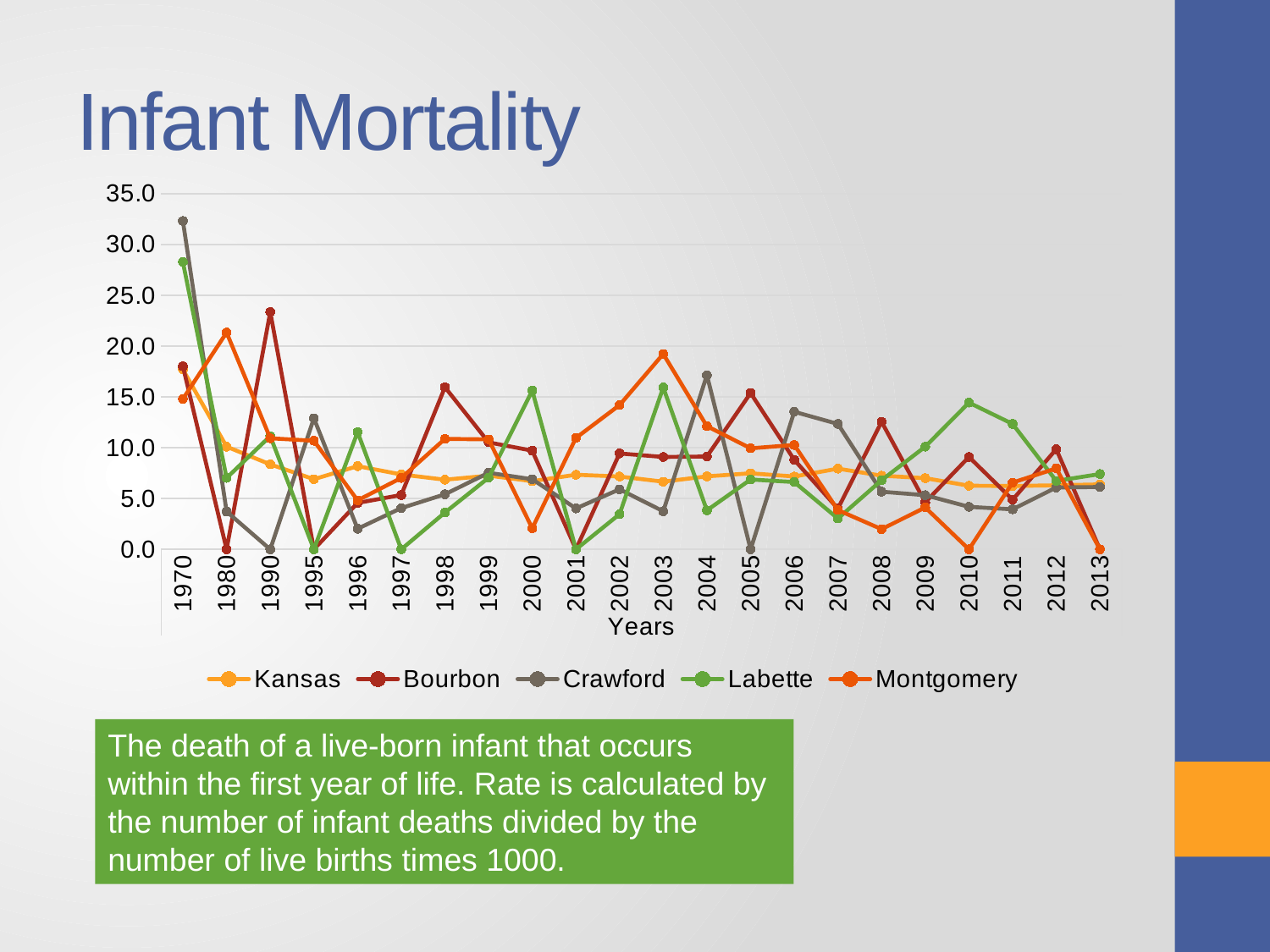
What is the value for Montgomery in 2013? 0.0 In which year does the Crawford series reach its highest value? 1970 Does the Kansas series generally rise or fall from 1970 to 2013? Fall What kind of chart is shown on the slide? Line chart How many series does the legend list? 5 Which is larger in 2010, the value for Labette or the value for Montgomery? Labette How many years are shown along the x axis? 22 Is the value for Kansas in 2013 greater or less than 10.0? less Is the value for Crawford in 1970 greater or less than 30.0? greater Which series has the highest value in 1970? Crawford Is the value for Bourbon in 1990 greater or less than 20.0? greater What is the title of the x axis? Years